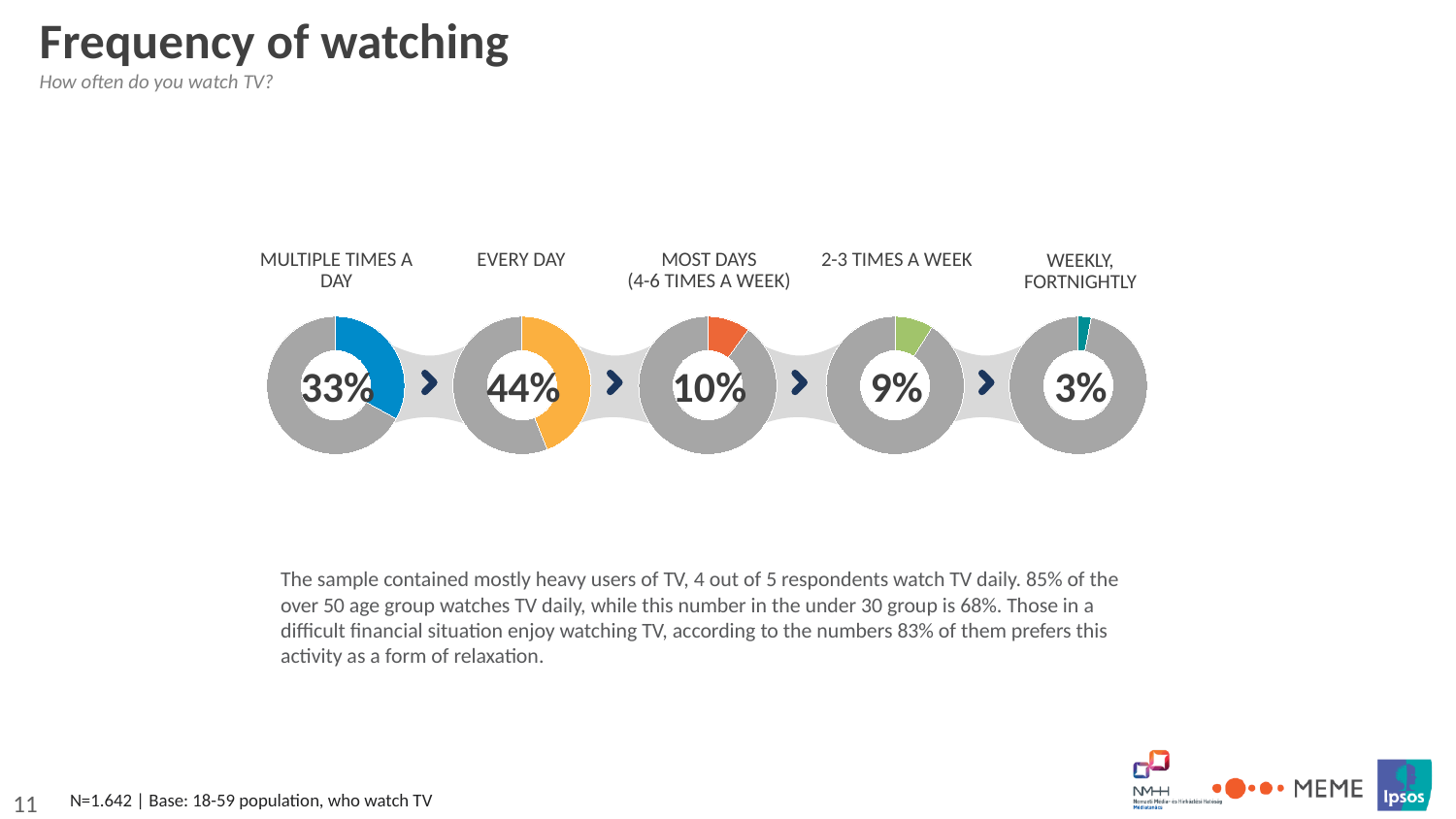
How many donut charts are shown on the slide? 5 Across the five donut charts, which watching frequency has the highest percentage? Every day In the '2-3 times a week' donut chart, what percentage is shown? 9% In the 'Most days (4-6 times a week)' donut chart, what percentage is shown? 10% Across the five donut charts, which watching frequency has the lowest percentage? Weekly, fortnightly Comparing the donut charts, which is larger: the 'Most days (4-6 times a week)' value or the '2-3 times a week' value? Most days (4-6 times a week) What colour is the highlighted segment in the 'Every day' donut chart? Orange What is the difference between the 'Every day' value and the 'Multiple times a day' value shown in the donut charts? 11% In the 'Multiple times a day' donut chart, what percentage is shown? 33% In the 'Weekly, fortnightly' donut chart, what percentage is shown? 3% In the 'Every day' donut chart, what percentage is shown? 44% What type of chart is used to show each watching frequency on the slide? Donut chart